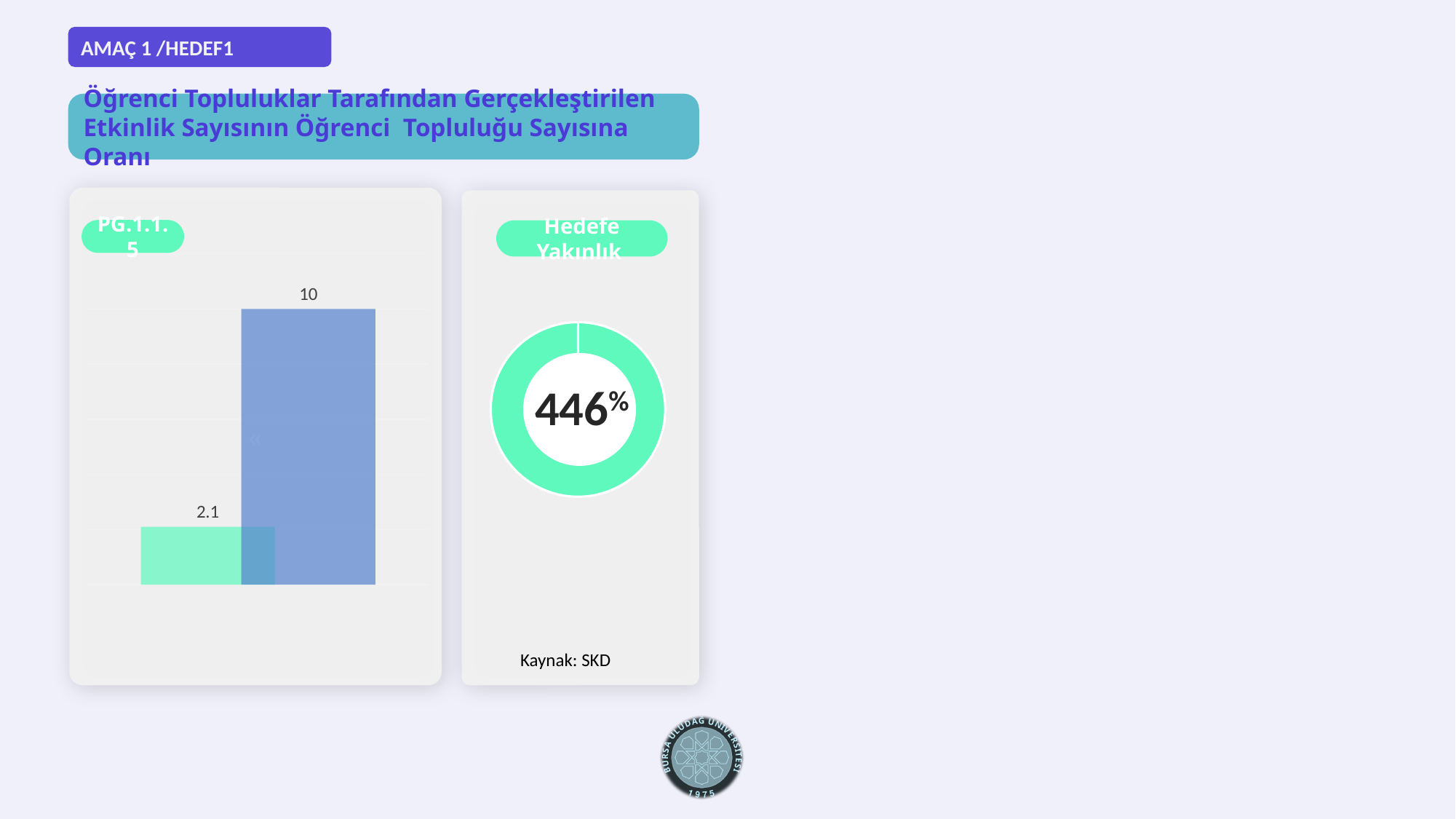
What percentage is printed in the centre of the donut chart under 'Hedefe Yakınlık'? 446% On the bar chart on the left, which bar is taller, the green one or the blue one? the blue one What kind of chart is shown in the left panel labelled PG.1.1.5? bar chart What is the source (Kaynak) given below the donut chart? SKD On the bar chart on the left, what is the difference between the two labelled bar values? 7.9 On the bar chart on the left, what value is printed above the shorter green bar? 2.1 On the bar chart on the left, what value is printed above the taller blue bar? 10 What kind of chart is shown in the right panel under 'Hedefe Yakınlık'? donut chart How many bars are plotted on the bar chart on the left? 2 What is the label in the green pill at the top of the left bar chart panel? PG.1.1.5